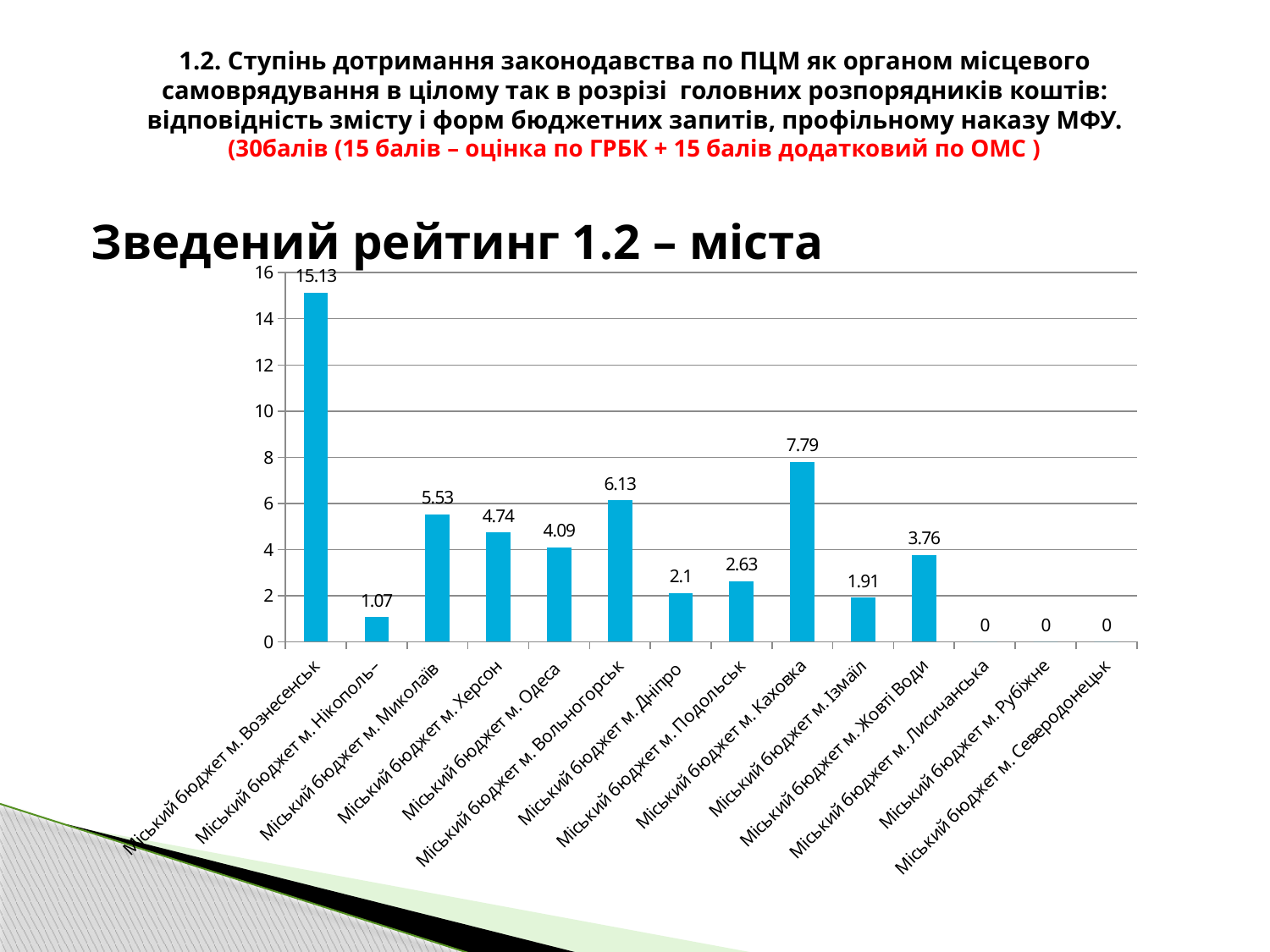
Which category has the highest value? Міський бюджет м. Вознесенськ What is the title of the chart? Зведений рейтинг 1.2 – міста Which is larger, the value for Міський бюджет м. Вольногорськ or Міський бюджет м. Миколаїв? Міський бюджет м. Вольногорськ What is the value for Міський бюджет м. Ізмаїл? 1.91 What type of chart is shown on the slide? bar chart What is the value for Міський бюджет м. Одеса? 4.09 How many categories have a value of 0? 3 What is the value for Міський бюджет м. Вознесенськ? 15.13 What is the value for Міський бюджет м. Каховка? 7.79 Is the value for Міський бюджет м. Каховка greater or less than 6? greater What is the difference between the values for Міський бюджет м. Миколаїв and Міський бюджет м. Херсон? 0.79 How many categories are shown on the x axis of the chart? 14